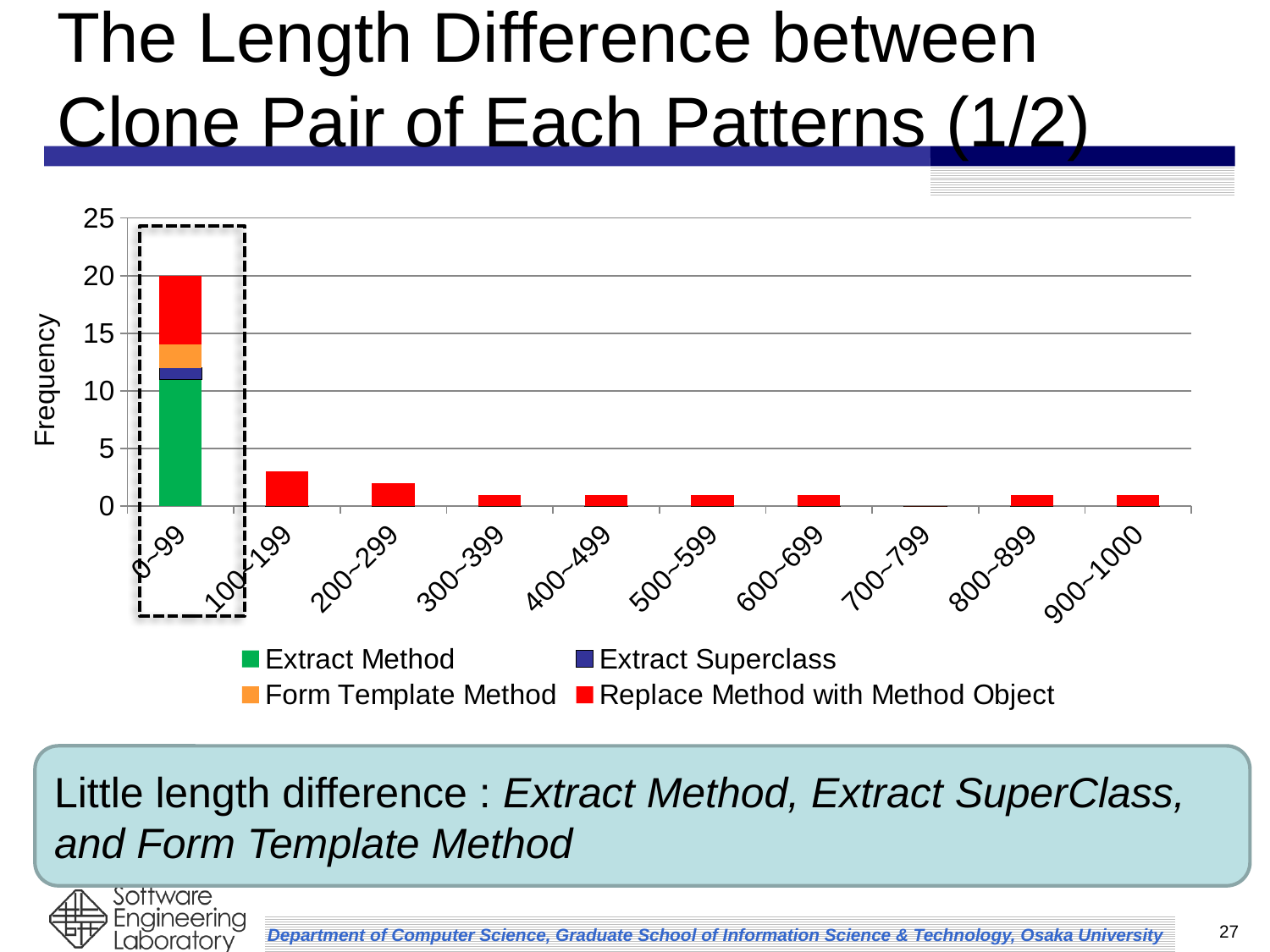
How many categories are shown on the x axis of the chart? 10 Is the frequency for the 100~199 category greater or less than 5? less Which category has the lowest total frequency? 700~799 What is the label of the y axis? Frequency How many series does the chart's legend list? 4 Which colour represents Extract Method in the legend? Green Is the Extract Method value in the 0~99 category greater or less than 10? greater Which category has the highest total frequency? 0~99 Do the total frequencies generally rise or fall as the length difference increases along the x axis? fall Which category has a larger total frequency, 0~99 or 100~199? 0~99 What kind of chart is shown on the slide? Stacked bar chart Is the total frequency for the 0~99 category greater or less than 15? greater